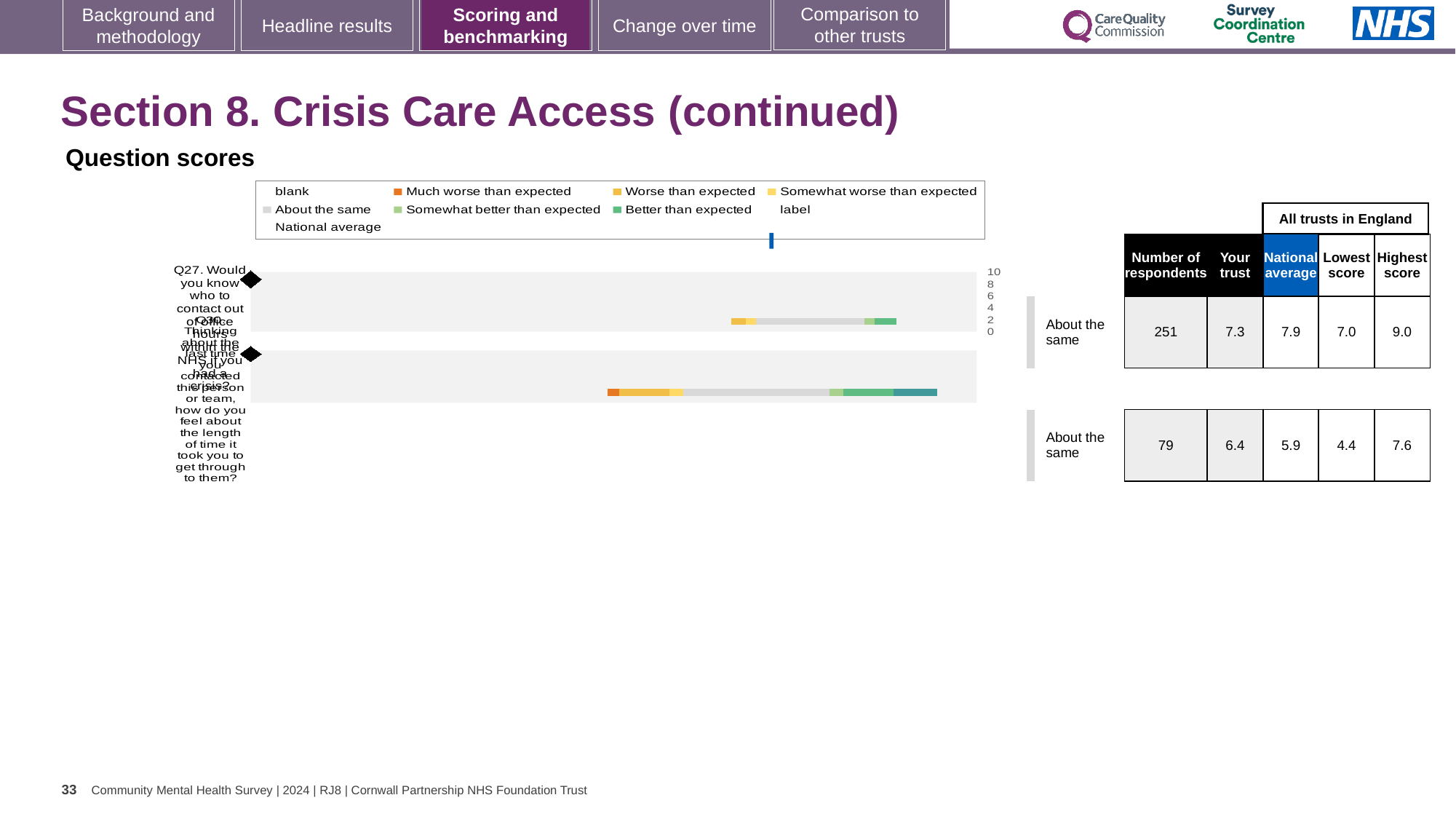
What is the highest score among all trusts in England for Q27? 9.0 What is the 'Your trust' score for Q27 (Would you know who to contact out of office hours within the NHS if you had a crisis?)? 7.3 What is the difference between the highest score and the lowest score for Q27? 2.0 What is the 'Your trust' score for Q30 (how do you feel about the length of time it took you to get through to them)? 6.4 What type of chart is used to show the question scores? Bar chart What is the difference between the highest score and the lowest score for Q30? 3.2 How many questions are plotted in the question scores chart? 2 How many respondents are shown for Q30? 79 How many respondents are shown for Q27 in the table next to the chart? 251 For Q27, which is higher: the 'Your trust' score or the national average? National average What is the lowest score among all trusts in England for Q30? 4.4 What is the national average score for Q27? 7.9